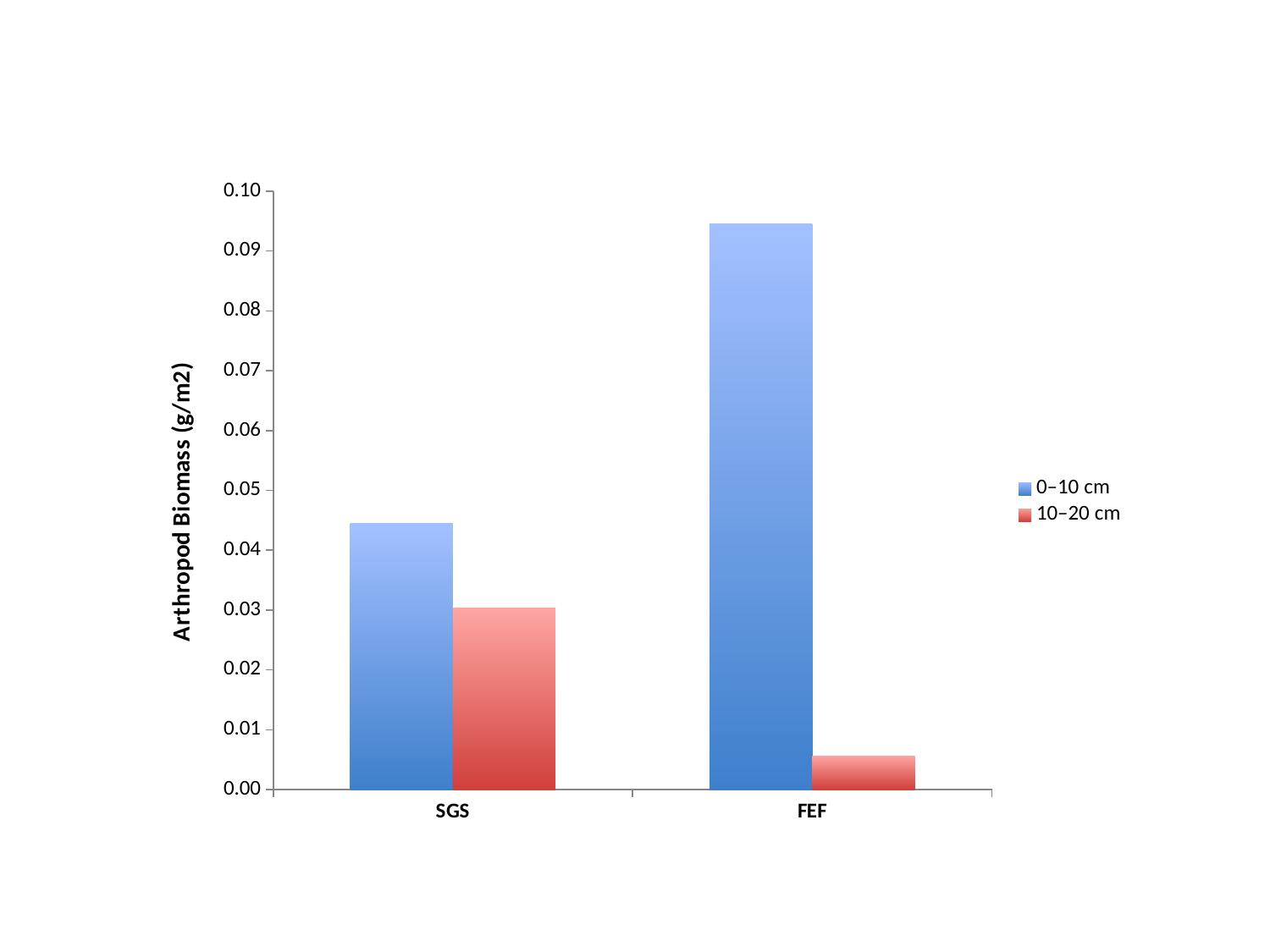
What is the label of the y axis? Arthropod Biomass (g/m2) Which category has the lowest 10–20 cm arthropod biomass? FEF Is the 0–10 cm value for SGS greater or less than 0.04? greater How many series does the legend list? 2 How many categories are shown on the x axis? 2 Which category has the highest 0–10 cm arthropod biomass? FEF Which is larger for SGS: the 0–10 cm value or the 10–20 cm value? 0–10 cm Is the 10–20 cm value for FEF greater or less than 0.01? less Which is larger: the 0–10 cm value for SGS or the 0–10 cm value for FEF? FEF Is the 0–10 cm value for FEF greater or less than 0.09? greater What kind of chart is shown on the slide? bar chart